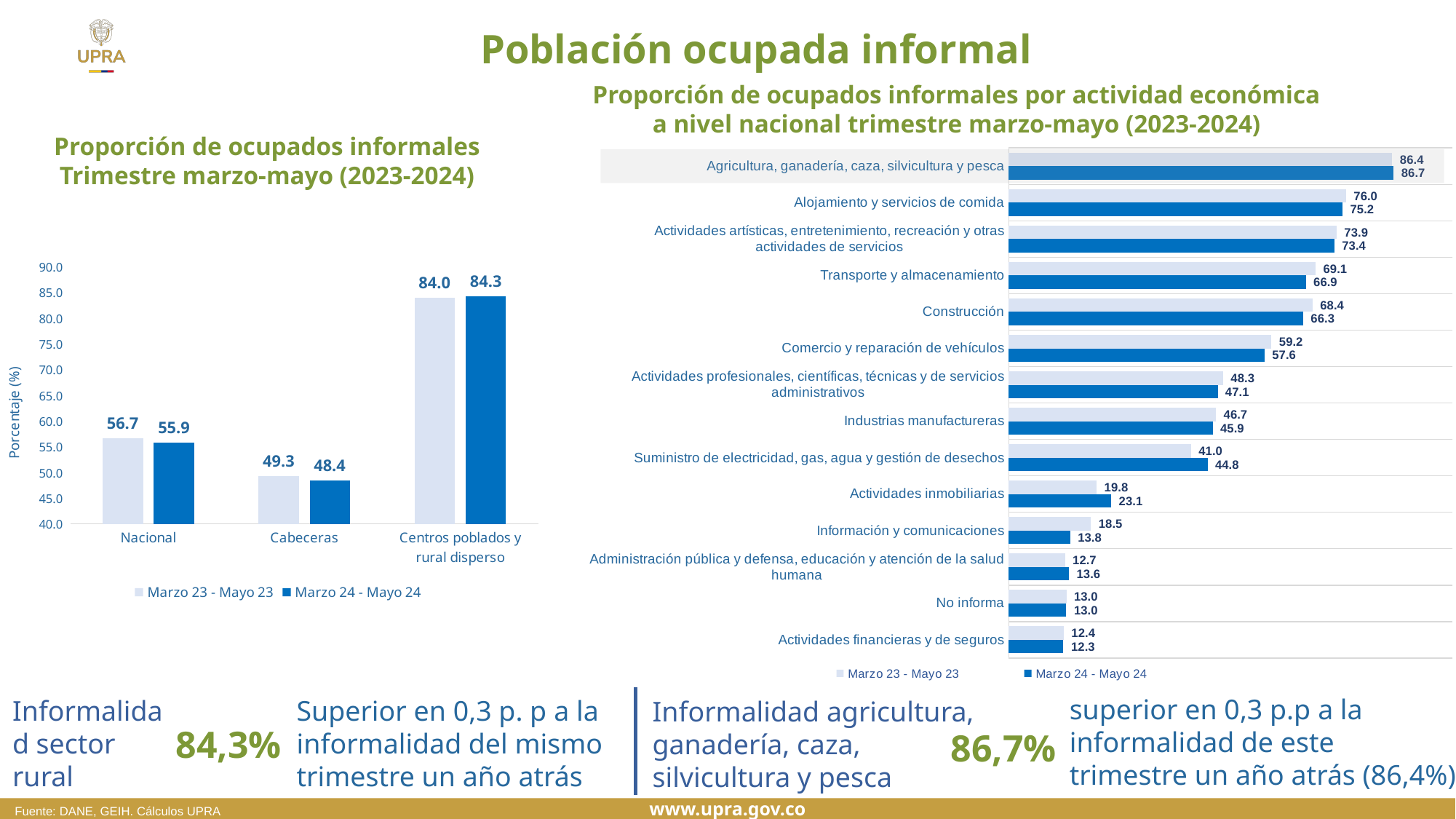
In the right chart (Proporción de ocupados informales por actividad económica), what is the value for Construcción in Marzo 24 - Mayo 24? 66.3 In the left chart (Proporción de ocupados informales Trimestre marzo-mayo), what is the value for Nacional in Marzo 24 - Mayo 24? 55.9 In the right chart (Proporción de ocupados informales por actividad económica), how many economic activities are listed? 14 In the left chart (Proporción de ocupados informales Trimestre marzo-mayo), what is the value for Cabeceras in Marzo 23 - Mayo 23? 49.3 In the left chart (Proporción de ocupados informales Trimestre marzo-mayo), what kind of chart is it? Bar chart In the right chart (Proporción de ocupados informales por actividad económica), what is the value for Actividades inmobiliarias in Marzo 23 - Mayo 23? 19.8 In the left chart (Proporción de ocupados informales Trimestre marzo-mayo), how many categories are shown on the x axis? 3 In the right chart (Proporción de ocupados informales por actividad económica), which is larger for Suministro de electricidad, gas, agua y gestión de desechos: Marzo 23 - Mayo 23 or Marzo 24 - Mayo 24? Marzo 24 - Mayo 24 In the left chart (Proporción de ocupados informales Trimestre marzo-mayo), what is the difference between the Marzo 24 - Mayo 24 and Marzo 23 - Mayo 23 values for Centros poblados y rural disperso? 0.3 In the right chart (Proporción de ocupados informales por actividad económica), which activity has the lowest value in Marzo 24 - Mayo 24? Actividades financieras y de seguros In the right chart (Proporción de ocupados informales por actividad económica), how many series does the legend list? 2 In the left chart (Proporción de ocupados informales Trimestre marzo-mayo), which category has the highest value in Marzo 24 - Mayo 24? Centros poblados y rural disperso